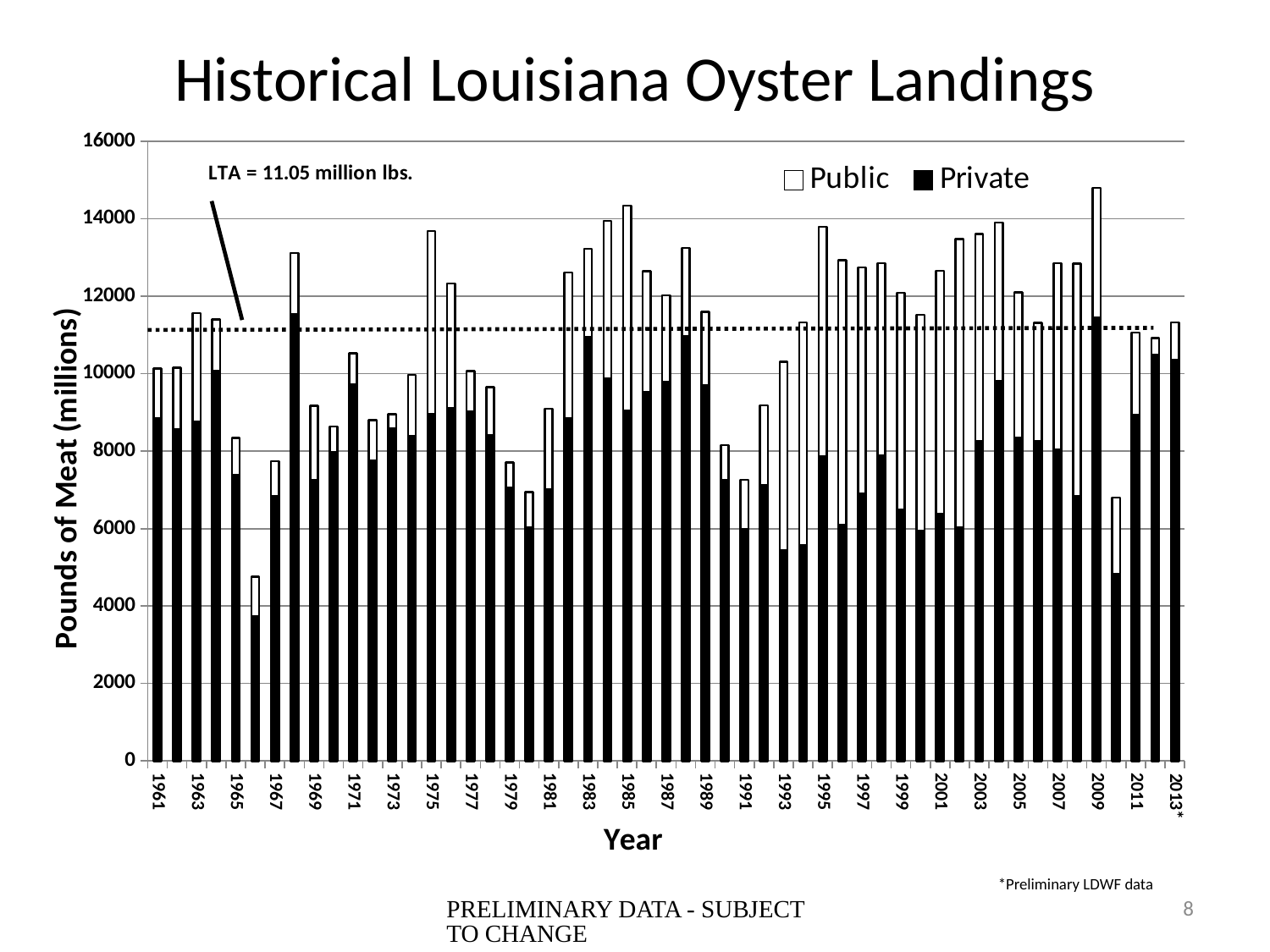
Which year has the larger total landings, 1985 or 1980? 1985 Is the total value for 2009 greater or less than 14000? greater Is the Private value for 1968 greater or less than 10000? greater Is the Private value for 2010 greater or less than 6000? less What value is given for the LTA on the chart? 11.05 million lbs. Which year has the lowest total landings? 1966 How many series does the legend list? 2 Which year has the highest total landings? 2009 What kind of chart is shown on the slide? Stacked bar chart What is the label of the vertical axis? Pounds of Meat (millions)